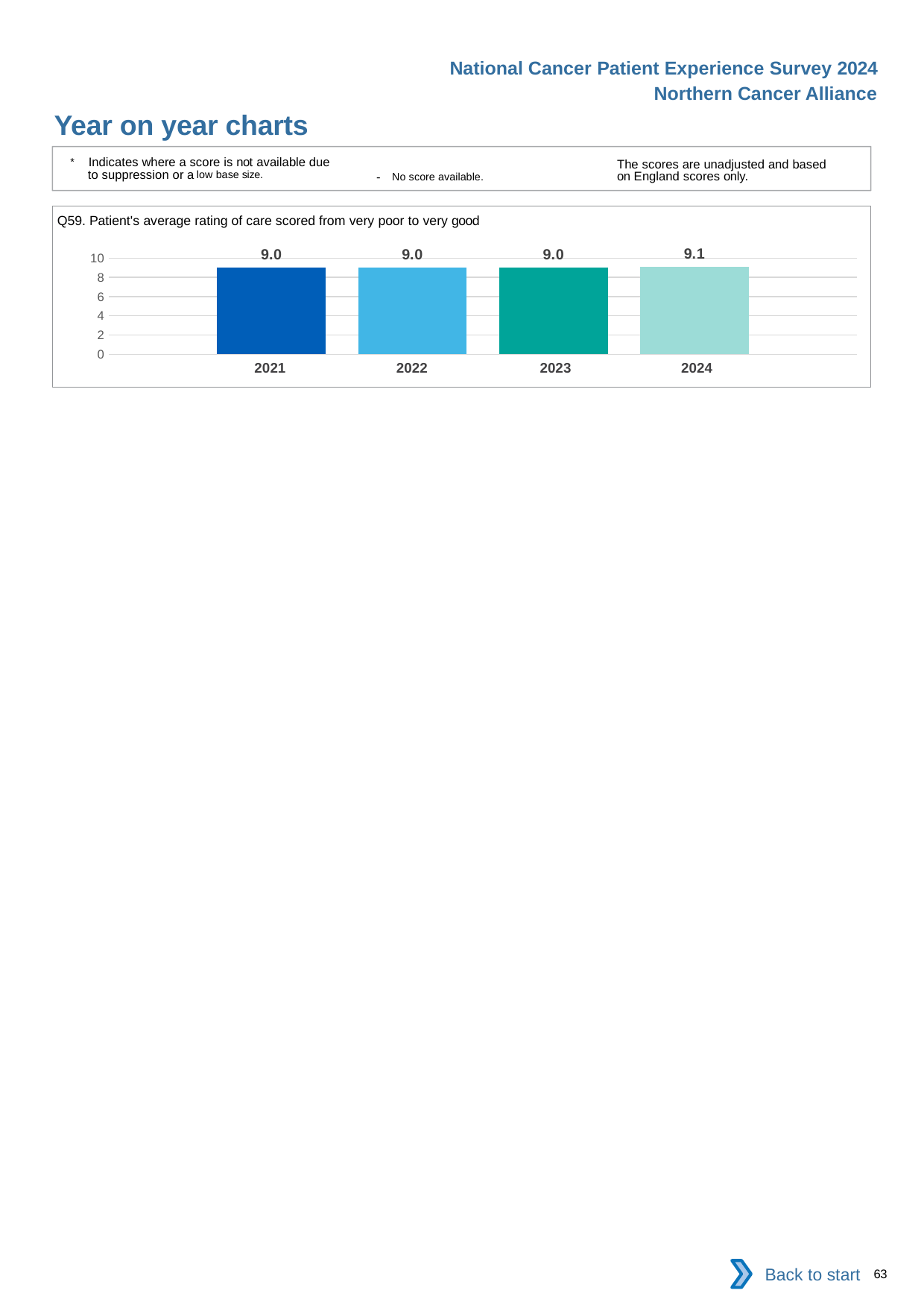
What is the difference between the values for 2024 and 2021? 0.1 Do the values rise or fall from 2023 to 2024? rise What kind of chart is shown? bar chart Which is larger, the value for 2022 or the value for 2024? 2024 What is the value for 2023? 9.0 What is the value for 2024? 9.1 Which year has the highest value? 2024 Is the value for 2022 greater or less than 8? greater What is the title of the chart? Q59. Patient's average rating of care scored from very poor to very good What is the value for 2021? 9.0 What is the highest value shown on the vertical axis? 10 How many years are shown on the chart? 4